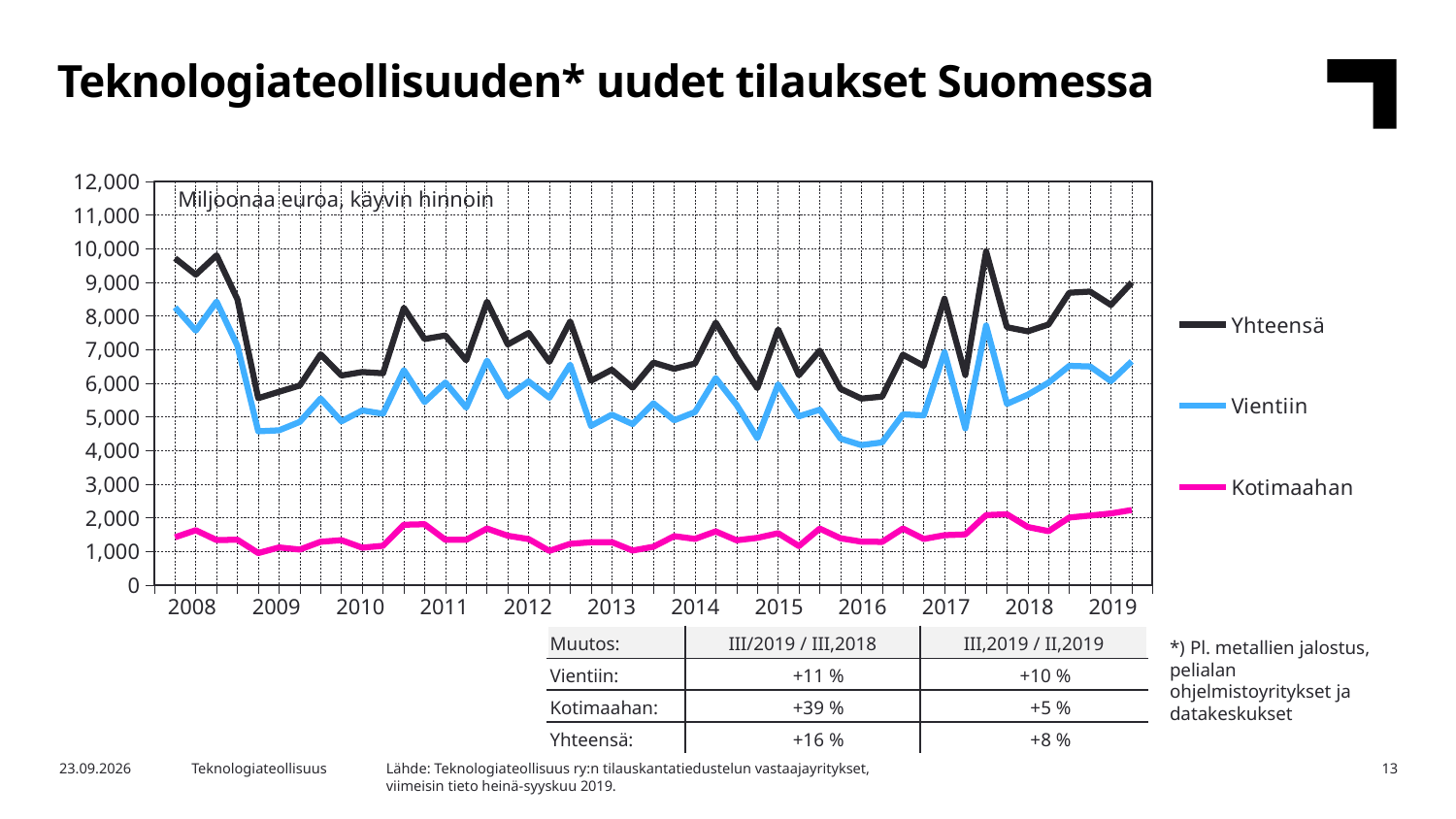
Is the peak value of Yhteensä in 2017 greater or less than 9,000? greater Which series has the highest values throughout the whole chart? Yhteensä Which series is larger in 2018, Vientiin or Kotimaahan? Vientiin Which series has the lowest values throughout the whole chart? Kotimaahan Does the Yhteensä series rise or fall from the start of 2008 to the start of 2009? fall Is the Kotimaahan value in 2019 greater or less than 3,000? less Is the Vientiin value at the start of 2009 greater or less than 5,000? less What kind of chart is shown on the slide? line chart What is the title of the slide containing the chart? Teknologiateollisuuden* uudet tilaukset Suomessa How many year labels are shown on the x axis of the chart? 12 What are the three series named in the chart legend? Yhteensä, Vientiin, Kotimaahan How many series does the chart legend list? 3